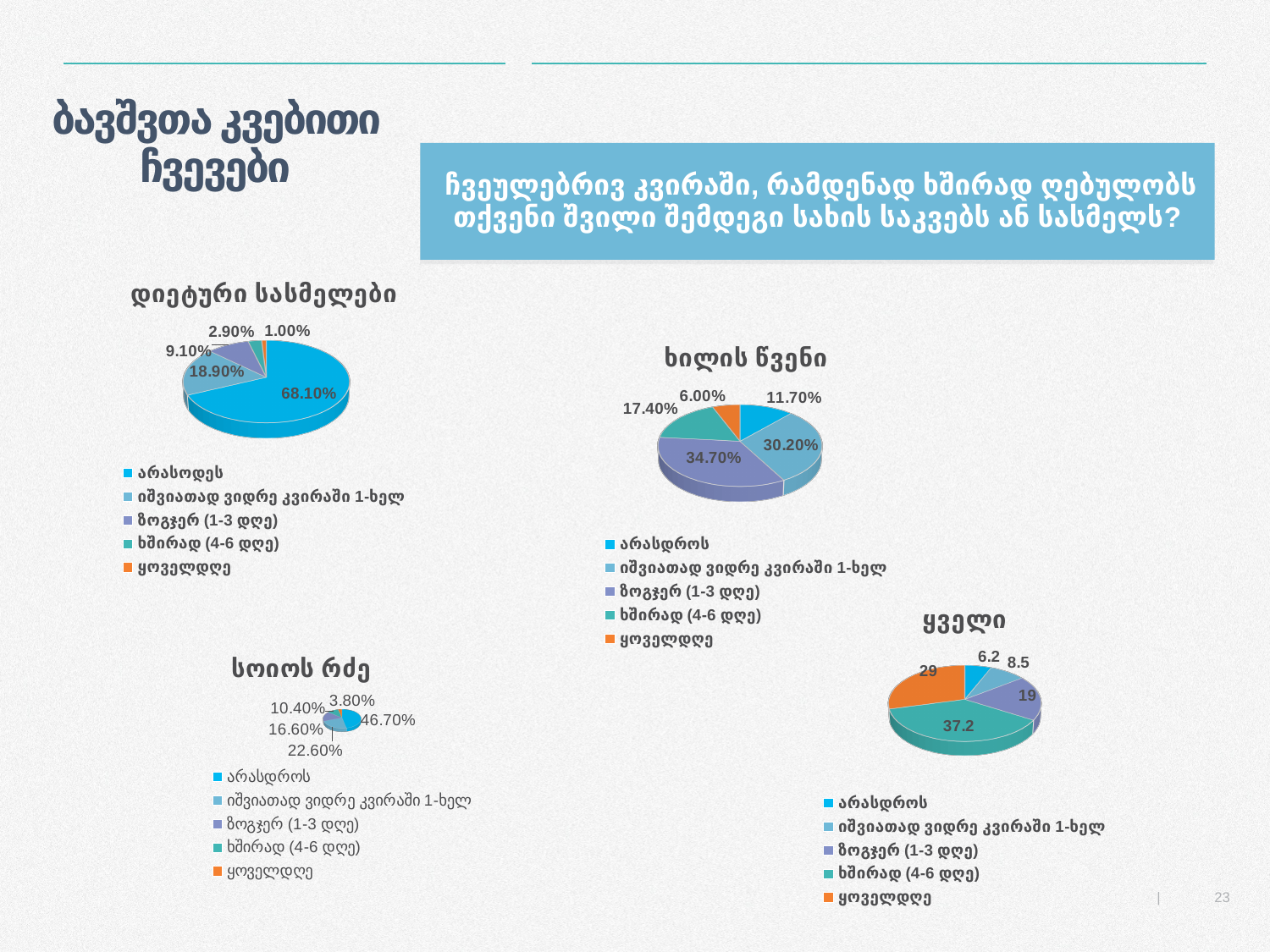
How many entries does the legend of the chart titled "ხილის წვენი" list? 5 How many pie charts are shown on the slide? 4 In the chart titled "სოიოს რძე", what is the value of the largest slice? 46.70% In the chart titled "სოიოს რძე", what is the value for "ყოველდღე"? 3.80% In the chart titled "ყველი", which category has the smallest slice? არასდროს In the chart titled "ყველი", which is larger: the "ყოველდღე" slice or the "ზოგჯერ (1-3 დღე)" slice? ყოველდღე In the chart titled "ხილის წვენი", what is the difference between the "ზოგჯერ (1-3 დღე)" slice and the "იშვიათად ვიდრე კვირაში 1-ხელ" slice? 4.50% In the chart titled "დიეტური სასმელები", what is the value of the smallest slice? 1.00% In the chart titled "ყველი", what is the value for "ხშირად (4-6 დღე)"? 37.2 In the chart titled "ხილის წვენი", what is the value for "ყოველდღე"? 6.00% In the chart titled "ხილის წვენი", what is the value for "ზოგჯერ (1-3 დღე)"? 34.70% In the chart titled "დიეტური სასმელები", what is the value of the largest slice? 68.10%